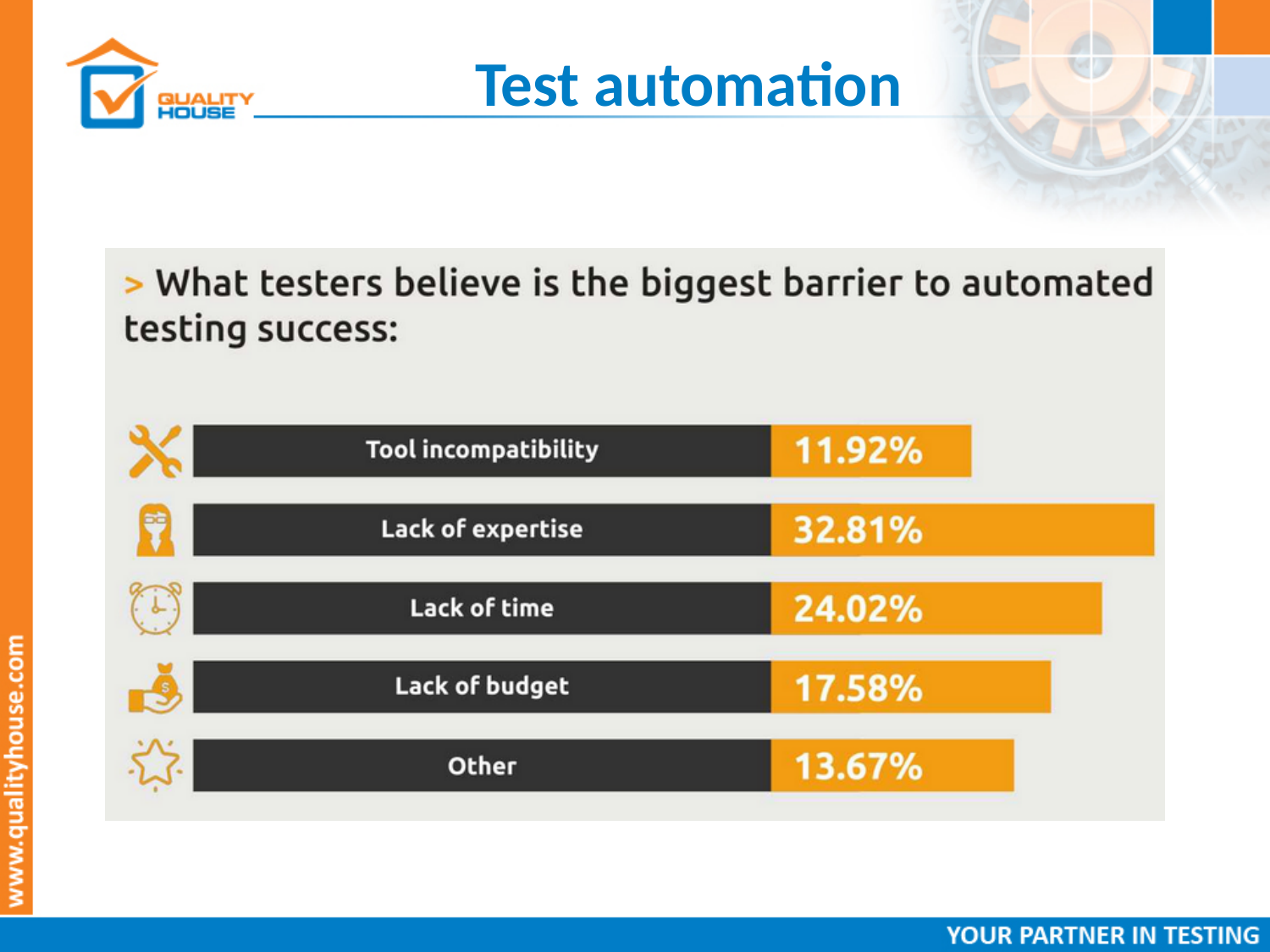
Which barrier has the lowest percentage? Tool incompatibility What kind of chart is used to show the barriers to automated testing success? Bar chart Which is larger, the value for Lack of time or the value for Lack of budget? Lack of time What is the difference between the percentages for Lack of expertise and Lack of time? 8.79% What percentage is shown for Lack of budget? 17.58% How many barrier categories are shown in the chart? 5 What is the difference between the percentages for Lack of budget and Other? 3.91% What percentage of testers cite Lack of expertise as the biggest barrier to automated testing success? 32.81% Which barrier has the highest percentage? Lack of expertise What is the value shown for Tool incompatibility? 11.92% What is the value for the Other category? 13.67% What colour are the bars in the chart? Orange